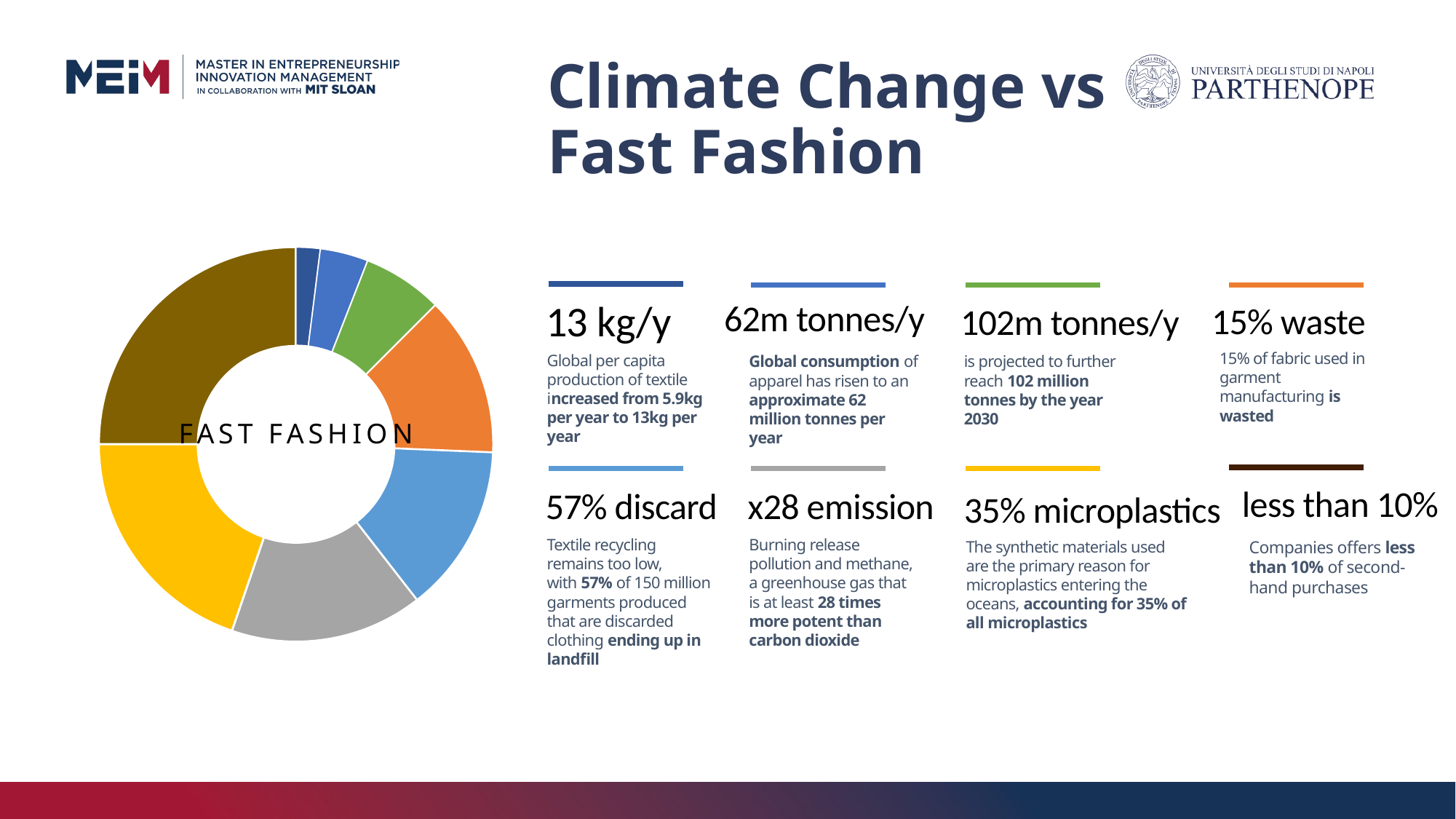
In the donut chart, which slice is larger, the yellow one or the green one? Yellow In the donut chart, which slice is larger, the dark brown one or the yellow one? Dark brown What kind of chart is shown on the left of the slide? Donut (pie) chart How many slices does the donut chart contain? 8 What text is written in the centre of the donut chart? FAST FASHION Which colour slice is the largest in the donut chart? Dark brown (olive) In the donut chart, which slice is larger, the orange one or the dark blue one? Orange Which colour slice is the smallest in the donut chart? Dark blue Does the donut chart display a legend? No